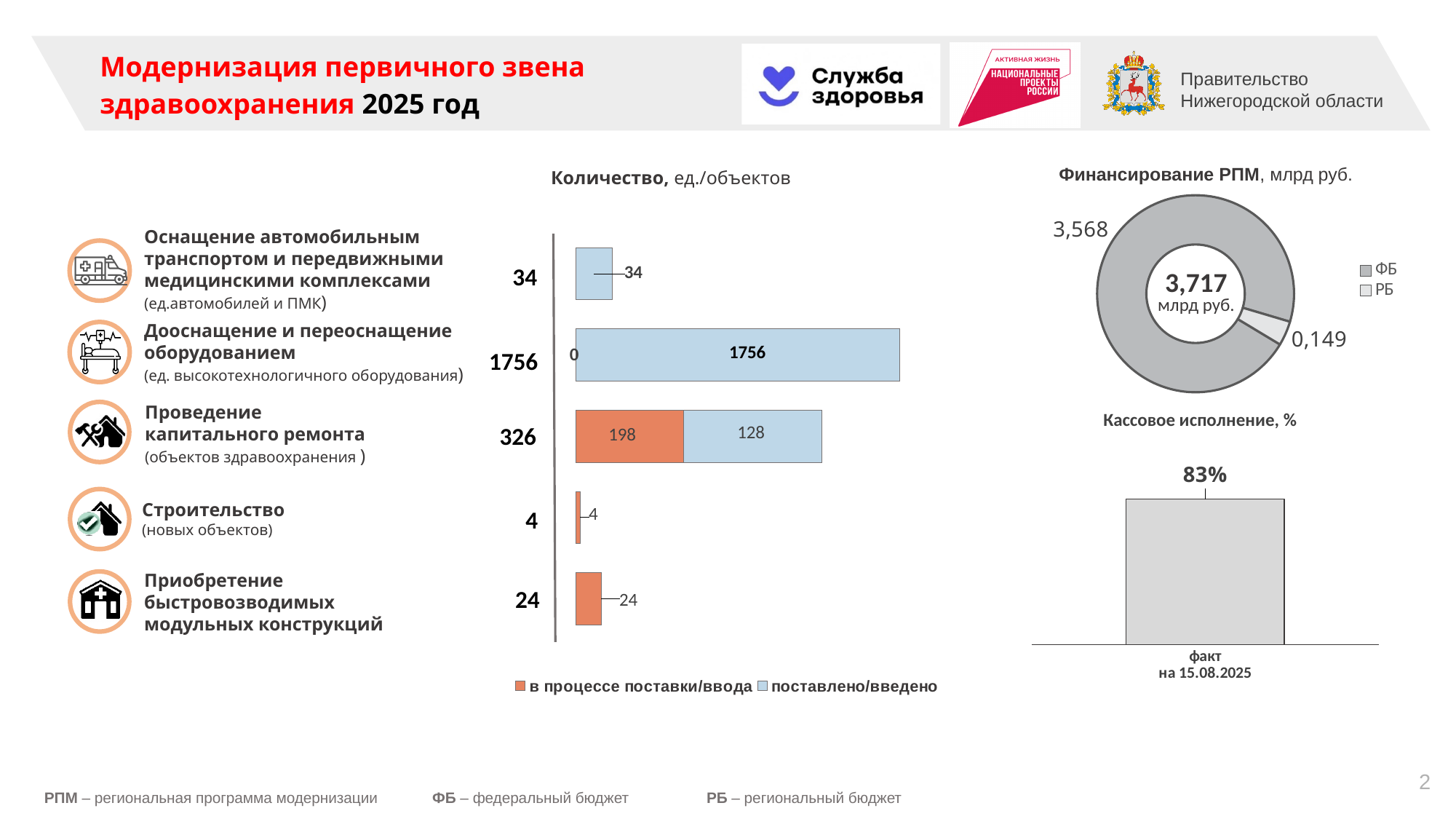
In the 'Количество, ед./объектов' chart, which category has the highest total value? Дооснащение и переоснащение оборудованием In the 'Количество, ед./объектов' chart, what is the value for 'Приобретение быстровозводимых модульных конструкций'? 24 In the 'Количество, ед./объектов' chart, how many series does the legend list? 2 In the 'Количество, ед./объектов' chart, which category has the lowest total value? Строительство What kind of chart is 'Финансирование РПМ, млрд руб.'? Donut (pie) chart In the 'Количество, ед./объектов' chart, what is the 'в процессе поставки/ввода' value for 'Проведение капитального ремонта'? 198 In the 'Количество, ед./объектов' chart, how many categories are shown? 5 In the 'Финансирование РПМ, млрд руб.' chart, what is the difference between ФБ and РБ? 3,419 In the 'Количество, ед./объектов' chart, what is the 'поставлено/введено' value for 'Проведение капитального ремонта'? 128 In the 'Финансирование РПМ, млрд руб.' chart, what is the value for ФБ? 3,568 In the 'Кассовое исполнение, %' chart, what is the value for 'факт на 15.08.2025'? 83% In the 'Количество, ед./объектов' chart, what is the total for 'Проведение капитального ремонта'? 326